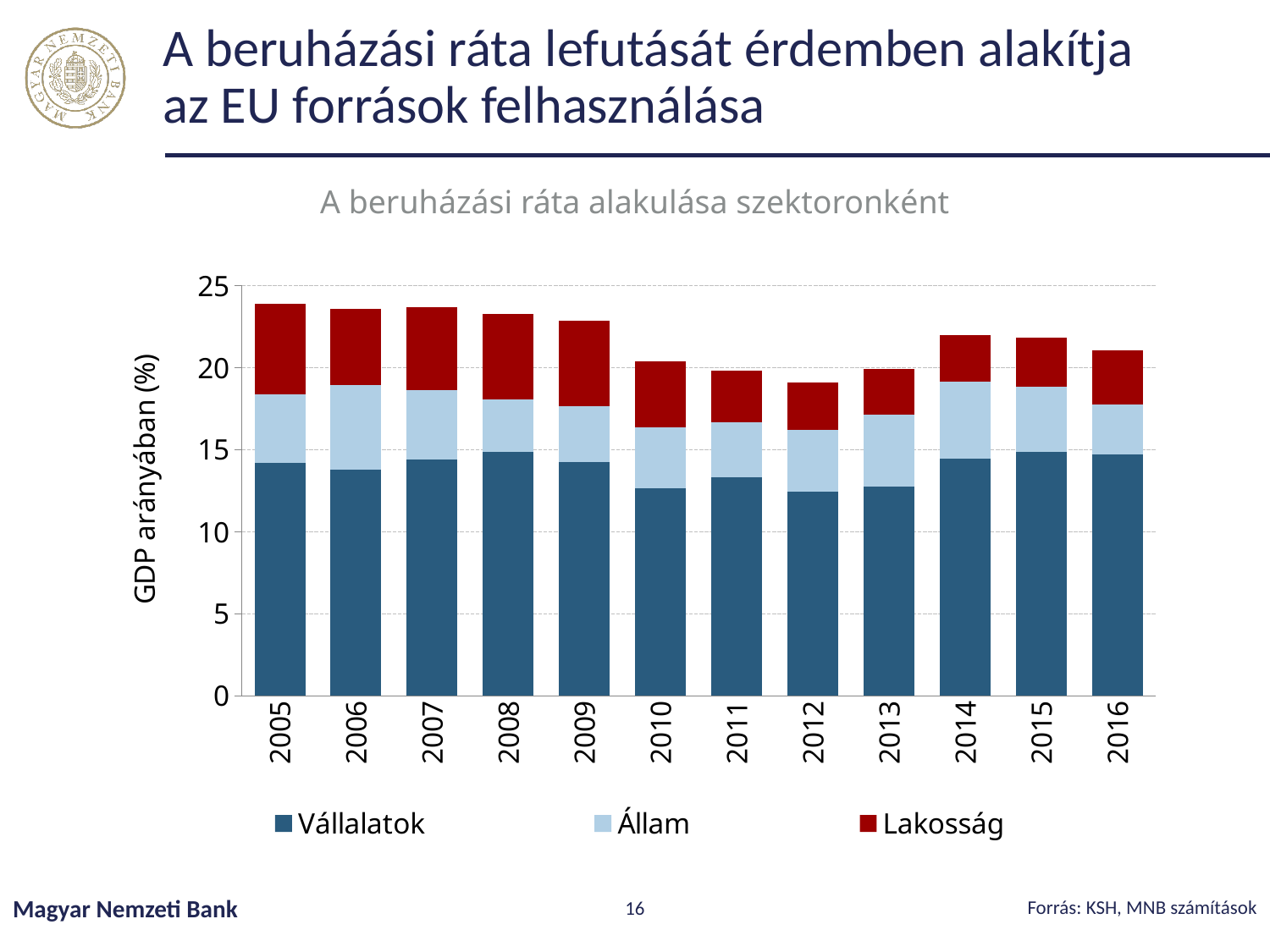
How many series does the legend list? 3 Which is larger, the total bar for 2005 or the total bar for 2012? 2005 What kind of chart is shown on the slide? Stacked bar chart Is the total investment rate for 2014 greater or less than 20? greater Is the total investment rate for 2012 greater or less than 20? less Is the total investment rate for 2005 greater or less than 20? greater Which is larger, the Vállalatok value for 2010 or for 2015? 2015 Do the total bars rise or fall from 2005 to 2012? fall How many years are shown on the x axis? 12 Which year has the lowest total investment rate? 2012 What is the label on the y axis? GDP arányában (%)